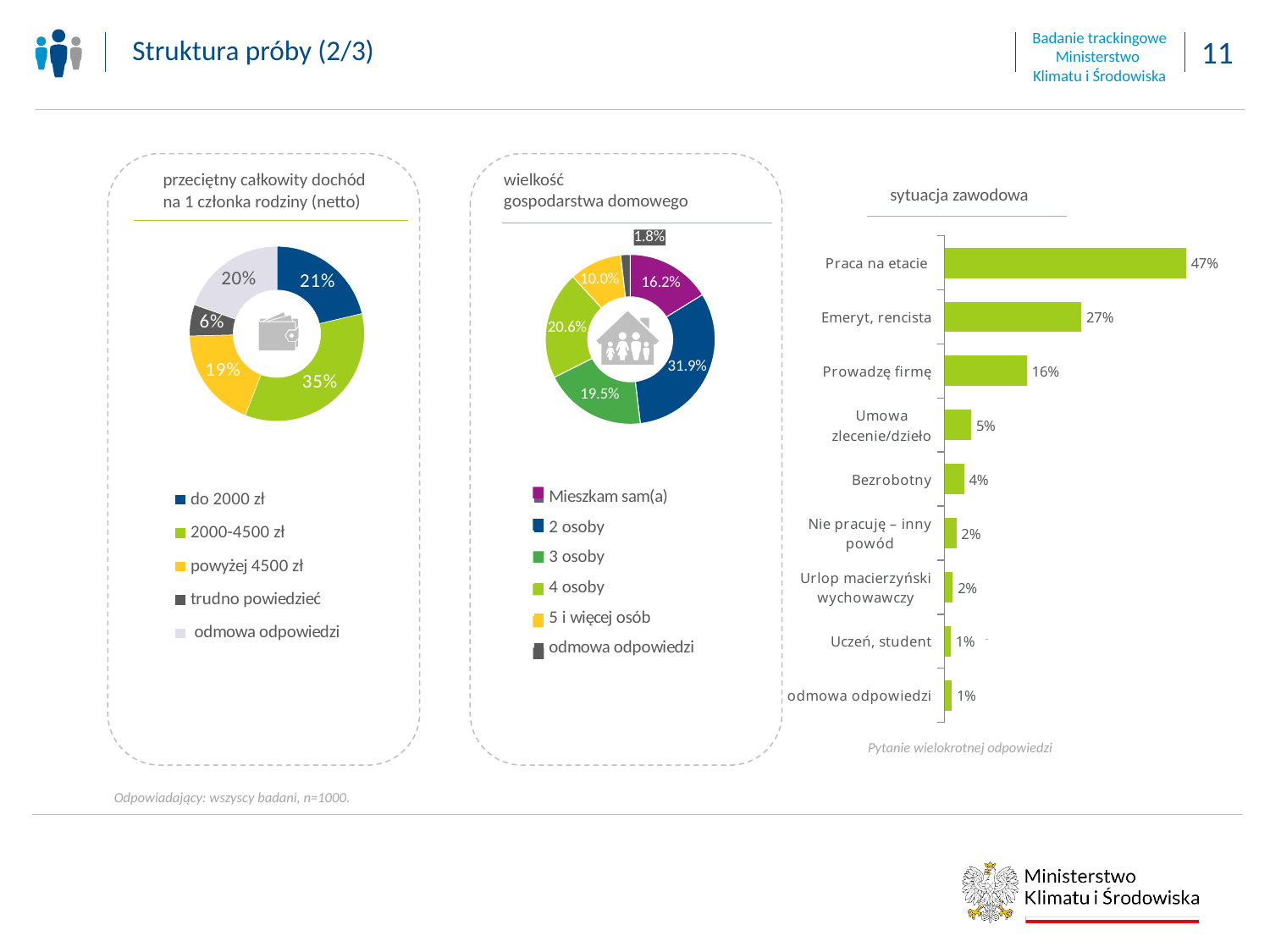
In the 'przeciętny całkowity dochód na 1 członka rodziny (netto)' chart, what share is shown for '2000-4500 zł'? 35% In the 'wielkość gospodarstwa domowego' chart, what share is shown for '2 osoby'? 31.9% In the 'sytuacja zawodowa' chart, which category has the highest value? Praca na etacie In the 'przeciętny całkowity dochód na 1 członka rodziny (netto)' chart, which category has the smallest share? trudno powiedzieć How many categories does the legend of the 'wielkość gospodarstwa domowego' chart list? 6 In the 'sytuacja zawodowa' chart, what is the difference between 'Praca na etacie' and 'Prowadzę firmę'? 31% In the 'sytuacja zawodowa' chart, what is the value for 'Emeryt, rencista'? 27% In the 'wielkość gospodarstwa domowego' chart, which category has the largest share? 2 osoby In the 'przeciętny całkowity dochód na 1 członka rodziny (netto)' chart, what is the difference between 'do 2000 zł' and 'powyżej 4500 zł'? 2% In the 'wielkość gospodarstwa domowego' chart, which is larger: '3 osoby' or '4 osoby'? 4 osoby What kind of chart is the 'przeciętny całkowity dochód na 1 członka rodziny (netto)' chart? Donut (pie) chart What kind of chart is the 'sytuacja zawodowa' chart? Bar chart